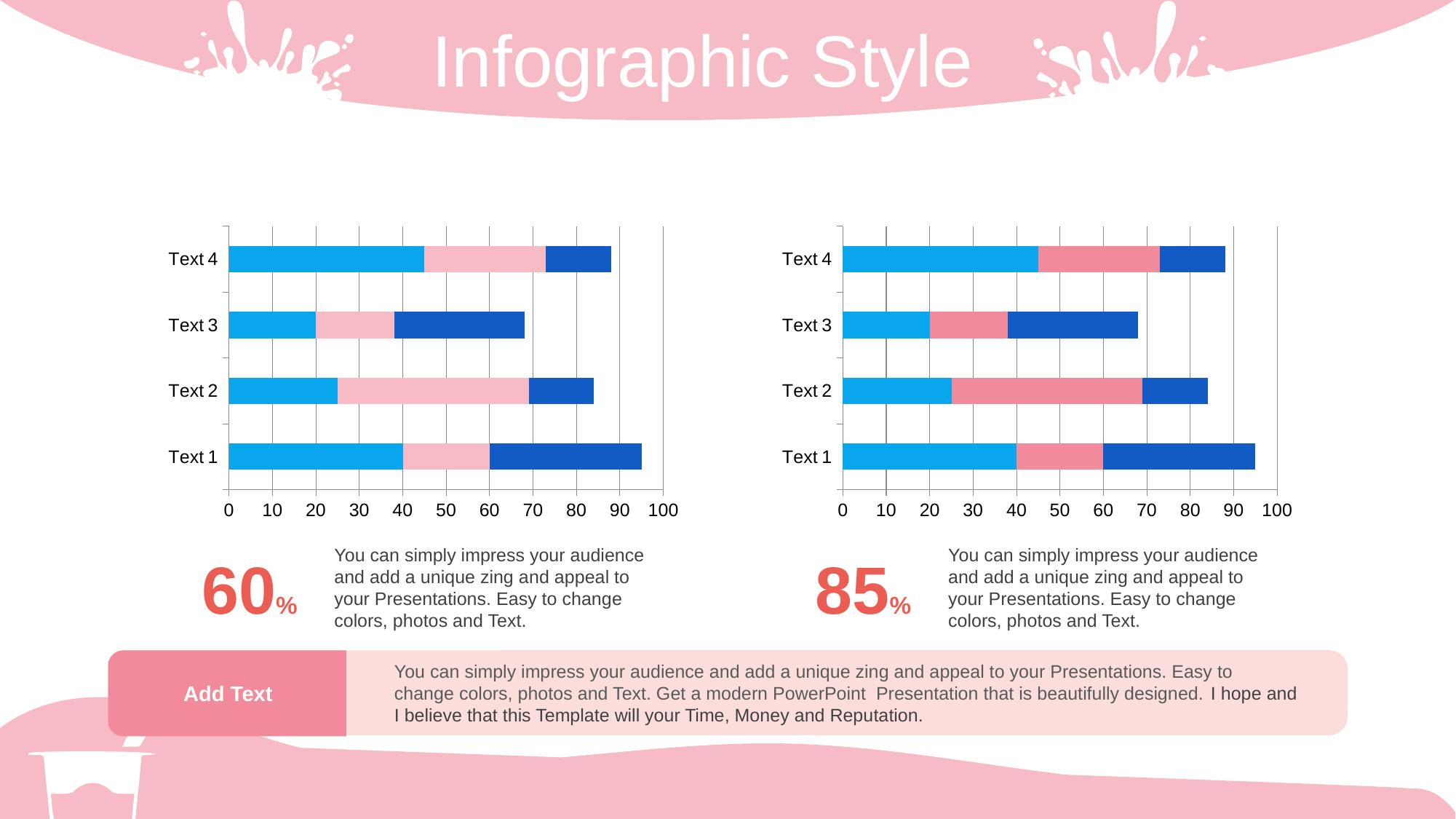
In the chart on the left side of the slide, is the total bar for Text 3 greater or less than 70? less How many coloured segments make up each bar in the chart on the right side of the slide? 3 In the chart on the right side of the slide, which category has the shortest total bar? Text 3 In the chart on the right side of the slide, which total bar is longer, Text 4 or Text 2? Text 4 In the chart on the left side of the slide, which category has the longest total bar? Text 1 In the chart on the left side of the slide, is the total bar for Text 1 greater or less than 90? greater What kind of chart is the chart on the left side of the slide? stacked bar chart In the chart on the left side of the slide, which category has the shortest total bar? Text 3 In the chart on the right side of the slide, which category has the longest total bar? Text 1 In the chart on the left side of the slide, which total bar is longer, Text 3 or Text 2? Text 2 In the chart on the right side of the slide, is the total bar for Text 2 greater or less than 80? greater How many categories does the chart on the left side of the slide show? 4